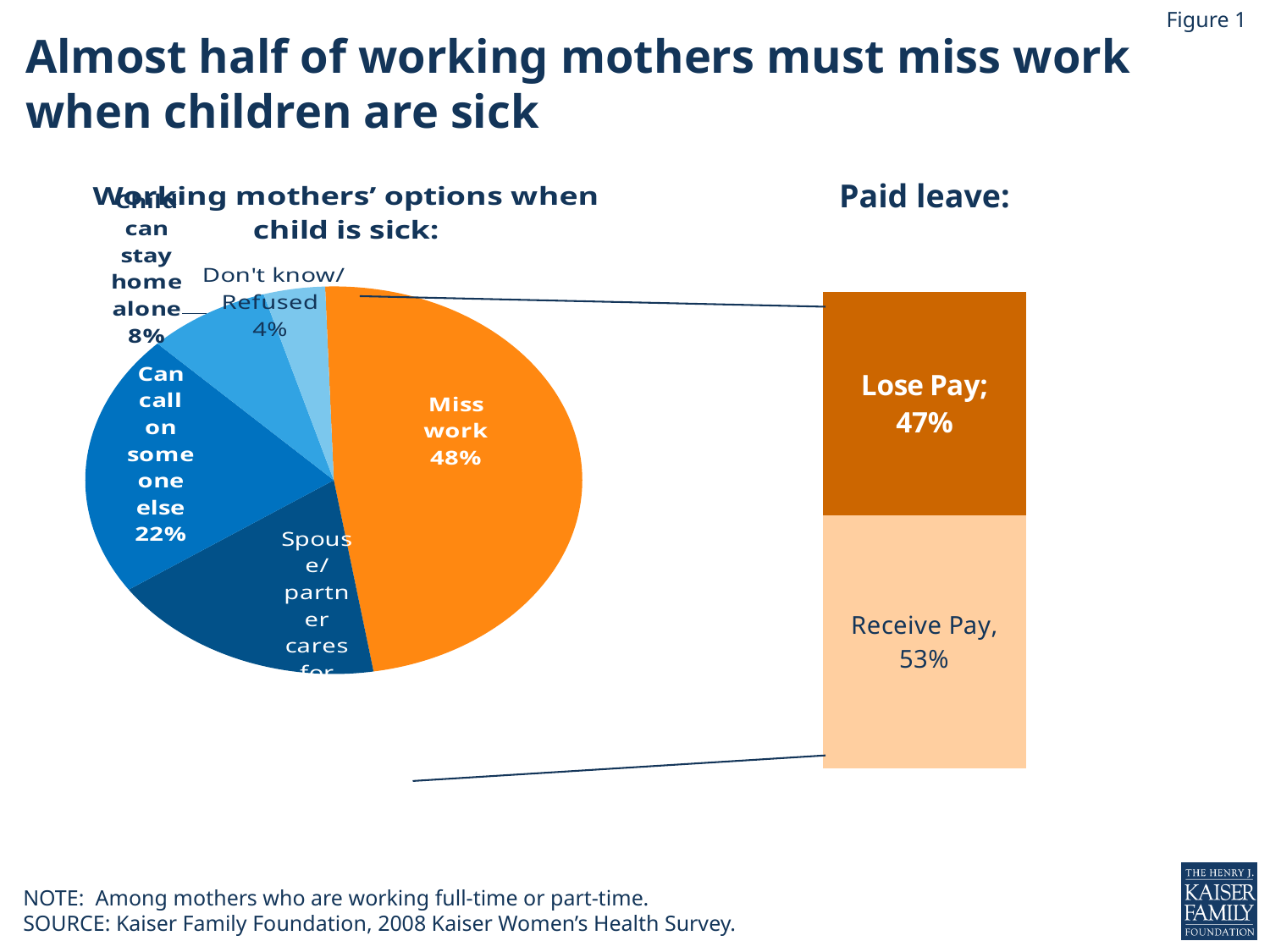
In the 'Paid leave' chart, what percentage of working mothers receive pay? 53% In the pie chart 'Working mothers' options when child is sick', how many slices does the pie have? 5 In the 'Paid leave' chart, what percentage of working mothers lose pay? 47% In the pie chart 'Working mothers' options when child is sick', how many percentage points larger is 'Miss work' than 'Can call on someone else'? 26 percentage points In the pie chart 'Working mothers' options when child is sick', what percentage say the child can stay home alone? 8% In the pie chart 'Working mothers' options when child is sick', what percentage answered Don't know/Refused? 4% In the pie chart 'Working mothers' options when child is sick', which category has the smallest share? Don't know/Refused What kind of chart is the chart on the left of the slide? Pie chart In the pie chart 'Working mothers' options when child is sick', which option has the largest share? Miss work In the 'Paid leave' chart, which is larger: Lose Pay or Receive Pay? Receive Pay In the pie chart 'Working mothers' options when child is sick', what percentage can call on someone else? 22% In the pie chart 'Working mothers' options when child is sick', what percentage of working mothers miss work? 48%